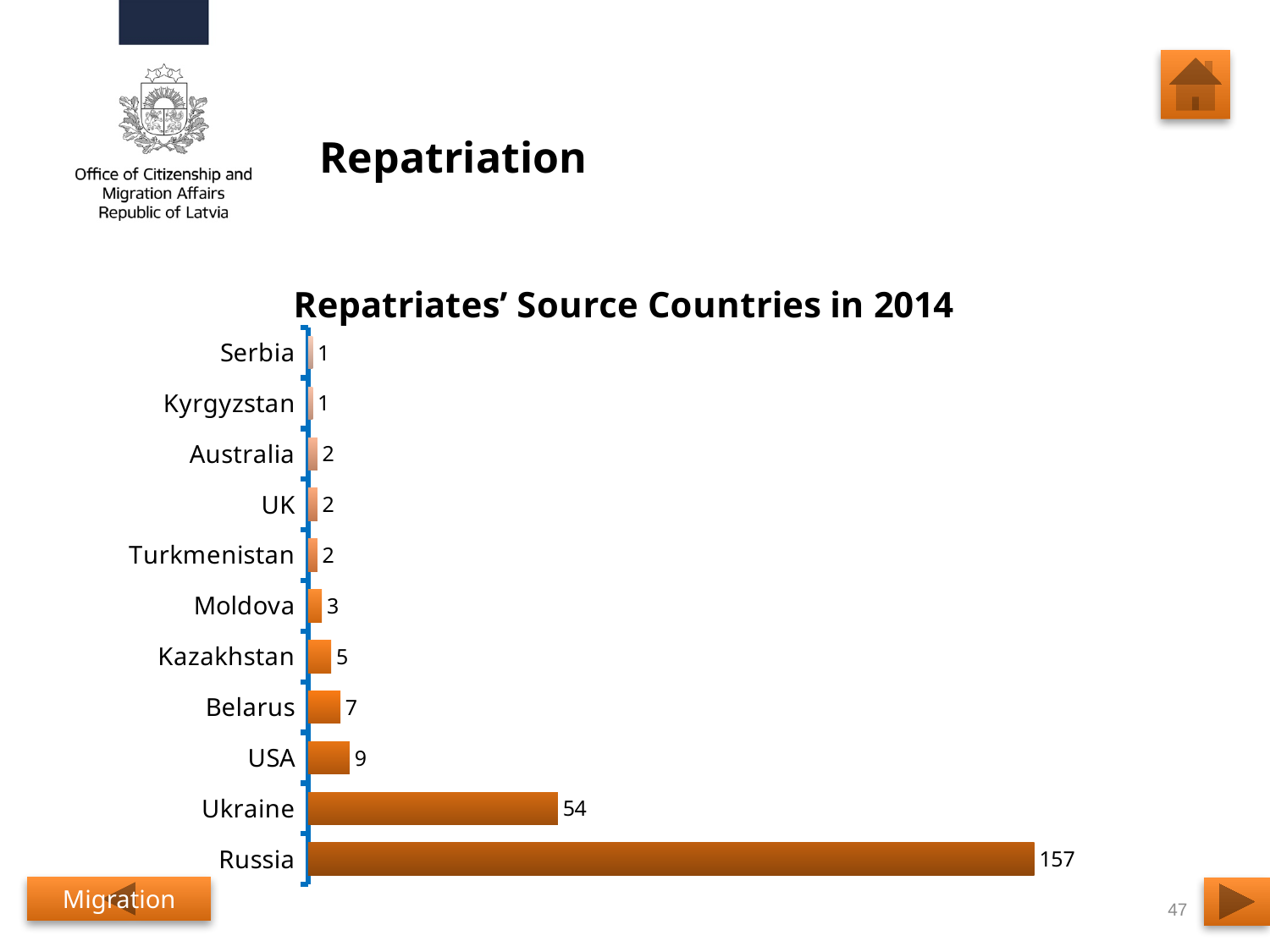
Which has a larger value, USA or Kazakhstan? USA What is the value for Ukraine? 54 Which has a larger value, Ukraine or USA? Ukraine What is the difference between the values for USA and Belarus? 2 What kind of chart is shown on the slide? Bar chart What is the value for Russia in the Repatriates' Source Countries in 2014 chart? 157 How many countries are shown in the chart? 11 What is the value for Moldova? 3 Which country has the highest value in the chart? Russia What is the title of the chart? Repatriates' Source Countries in 2014 What is the difference between the values for Russia and Ukraine? 103 What is the value for Belarus? 7